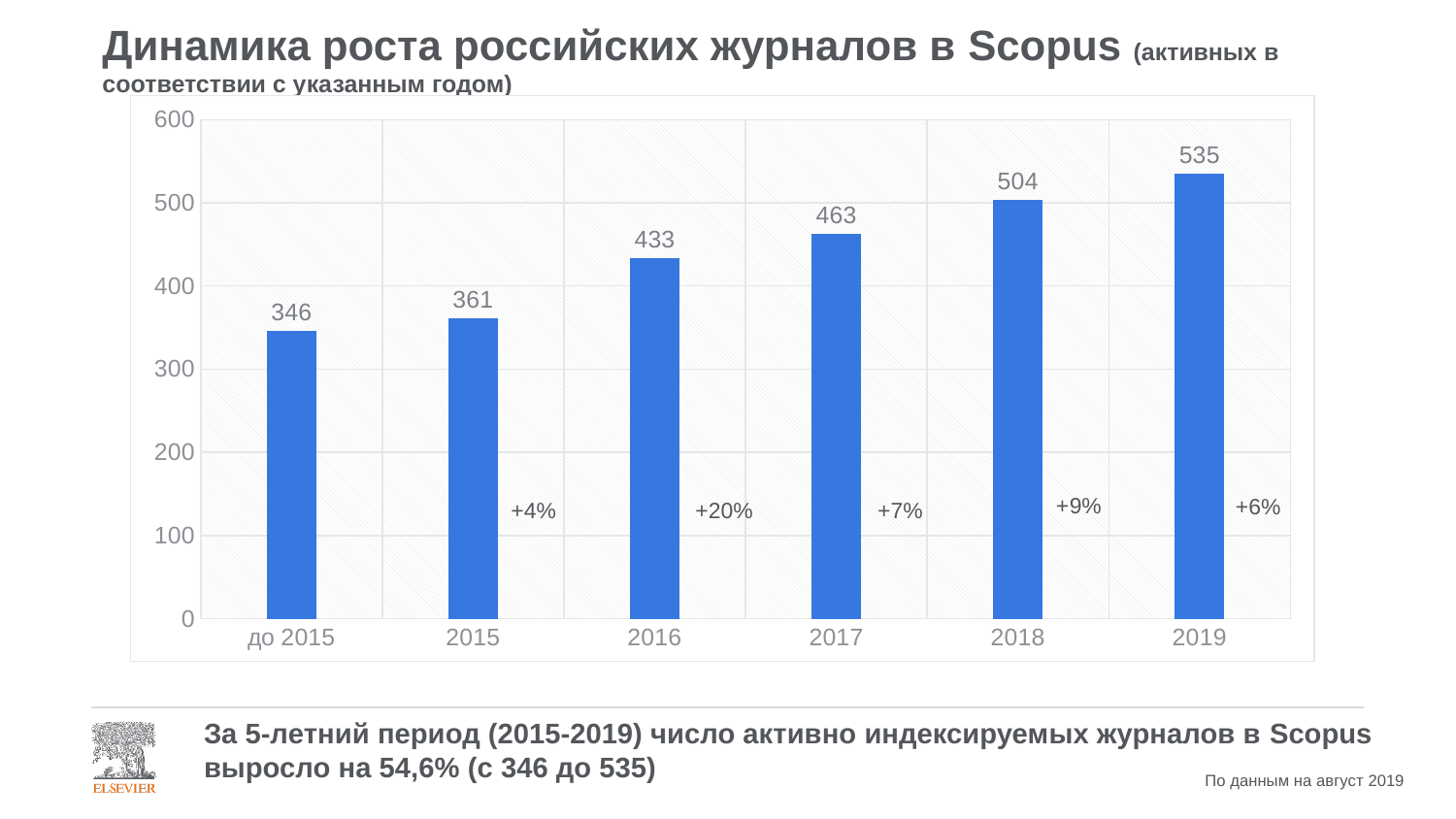
What is the value for 2016? 433 Which category has the highest value? 2019 Which is larger, the value for 2017 or the value for 2015? 2017 How many categories are shown on the x axis? 6 What is the value for 2018? 504 What is the value for the category 'до 2015'? 346 What is the difference between the values for 2019 and 2018? 31 Do the values rise or fall from left to right along the x axis? rise What is the difference between the values for 2016 and 2015? 72 What kind of chart is shown on the slide? bar chart Is the value for 2018 greater or less than 500? greater Which category has the lowest value? до 2015